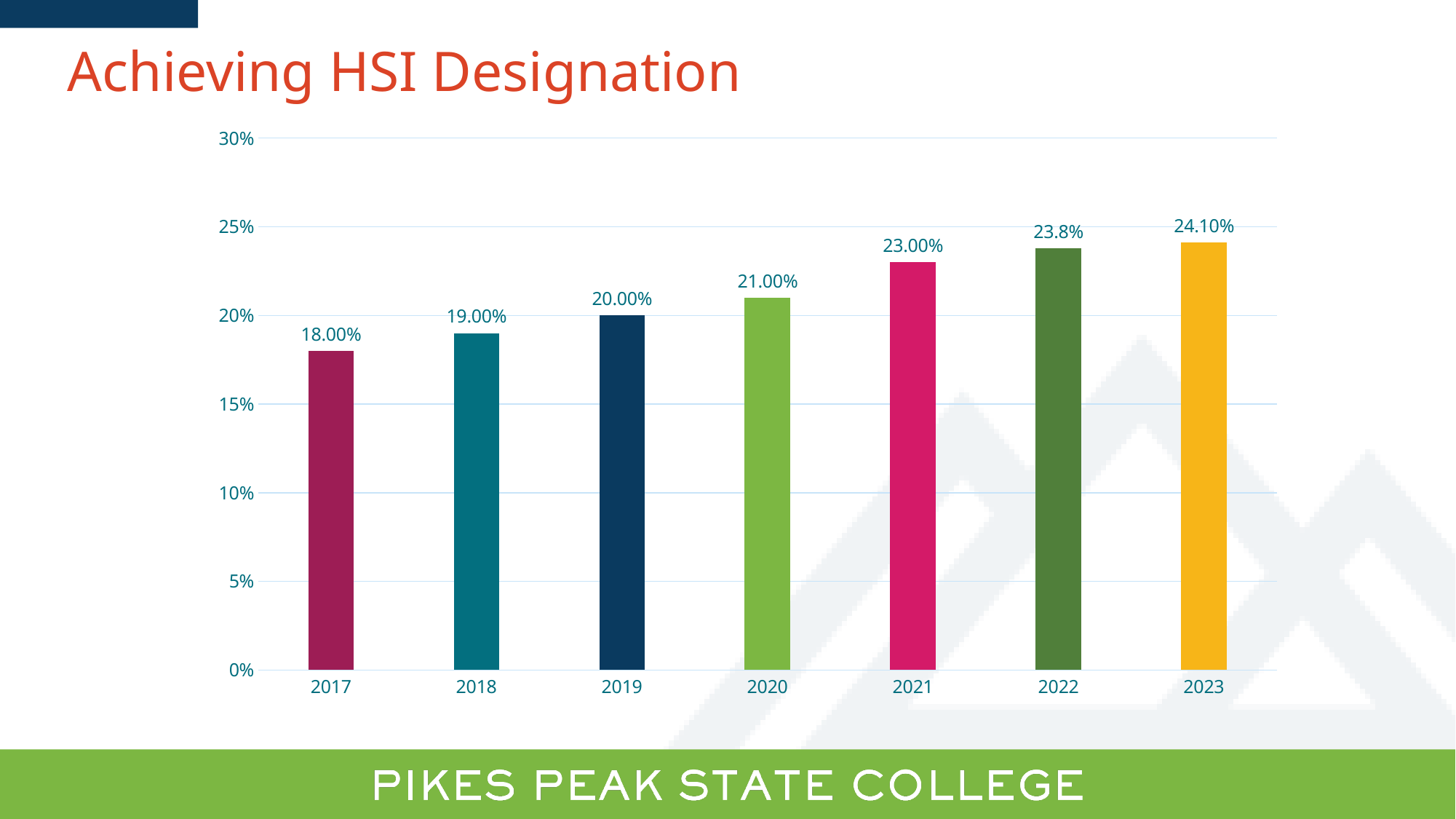
What is the difference between the values for 2021 and 2018? 4.00% Which is larger, the value for 2019 or the value for 2021? 2021 What is the value for 2022? 23.8% How many years are shown on the x axis? 7 Is the value for 2022 greater or less than 20%? greater What is the value for 2023? 24.10% Do the values rise or fall from 2017 to 2023? rise What is the value for 2020? 21.00% Which year has the highest value? 2023 What is the value for 2017? 18.00% What kind of chart is shown on the slide? bar chart Which year has the lowest value? 2017